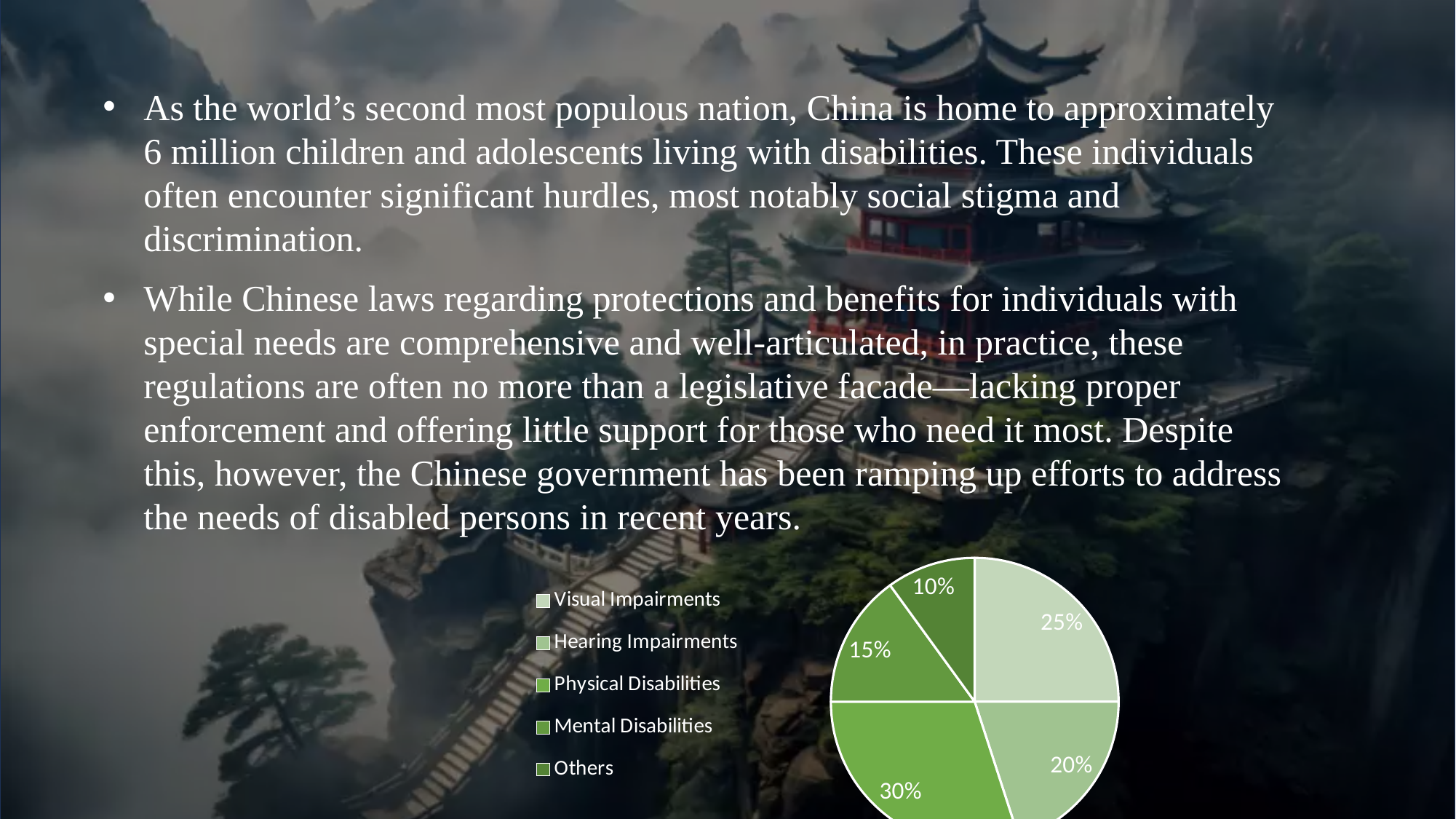
Which category has the largest slice of the pie? Physical Disabilities What is the difference in percentage points between Physical Disabilities and Mental Disabilities? 15% What share of the pie does Others take? 10% How many slices does the pie chart have? 5 What share of the pie does Hearing Impairments take? 20% How many entries does the legend of the pie chart list? 5 What share of the pie does Visual Impairments take? 25% Which category has the smallest slice of the pie? Others Which is larger, the slice for Visual Impairments or the slice for Hearing Impairments? Visual Impairments What kind of chart is shown on the slide? pie chart